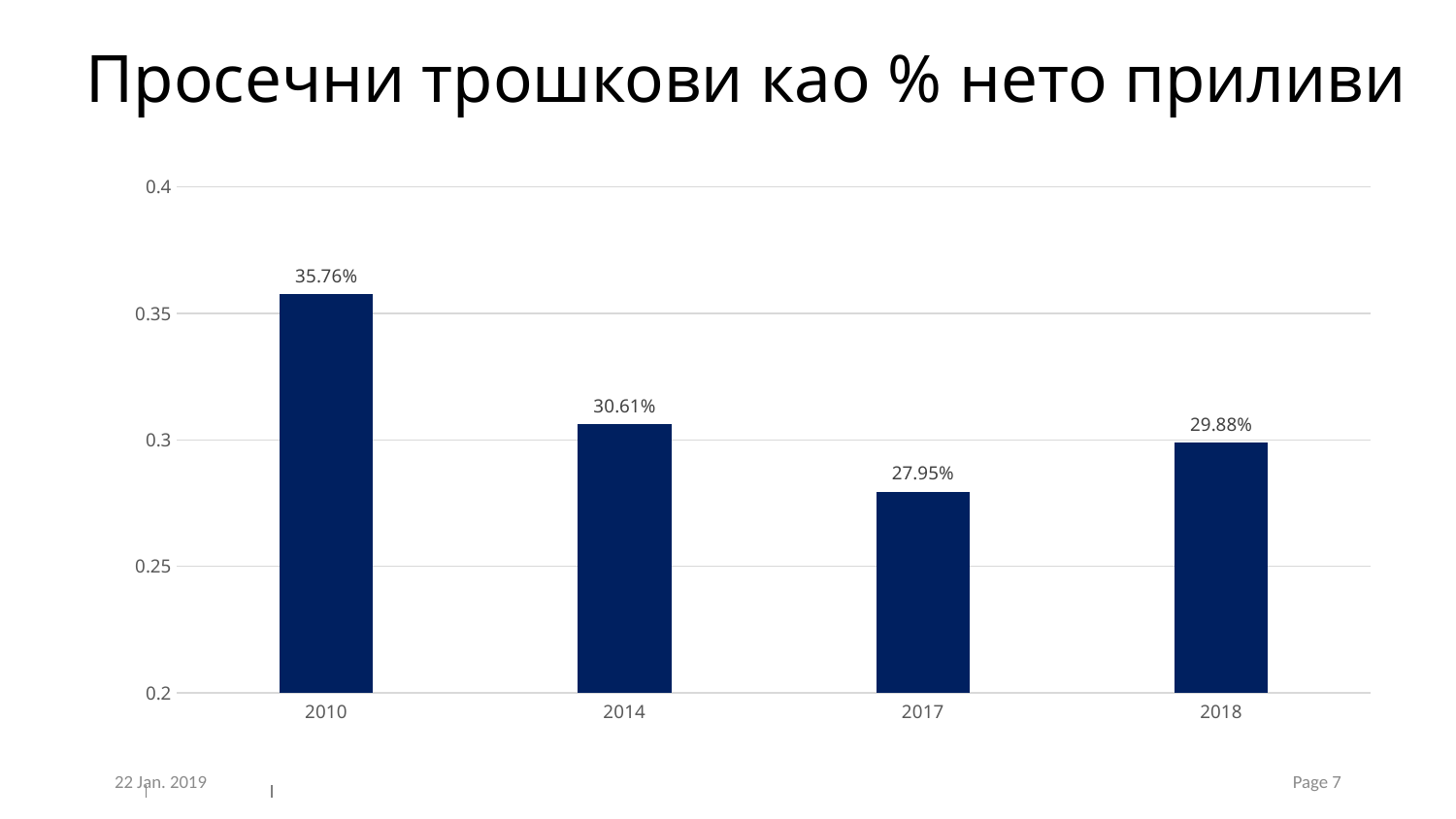
What is the value for 2010? 35.76% What is the value for 2017? 27.95% What is the difference between the values for 2010 and 2014? 5.15% Which is larger, the value for 2014 or the value for 2018? 2014 Which year has the lowest value? 2017 What kind of chart is shown on the slide? bar chart What is the value for 2018? 29.88% What is the difference between the values for 2018 and 2017? 1.93% How many years are shown on the chart? 4 What is the value for 2014? 30.61% Which year has the highest value? 2010 Is the value for 2017 greater or less than 0.3? less